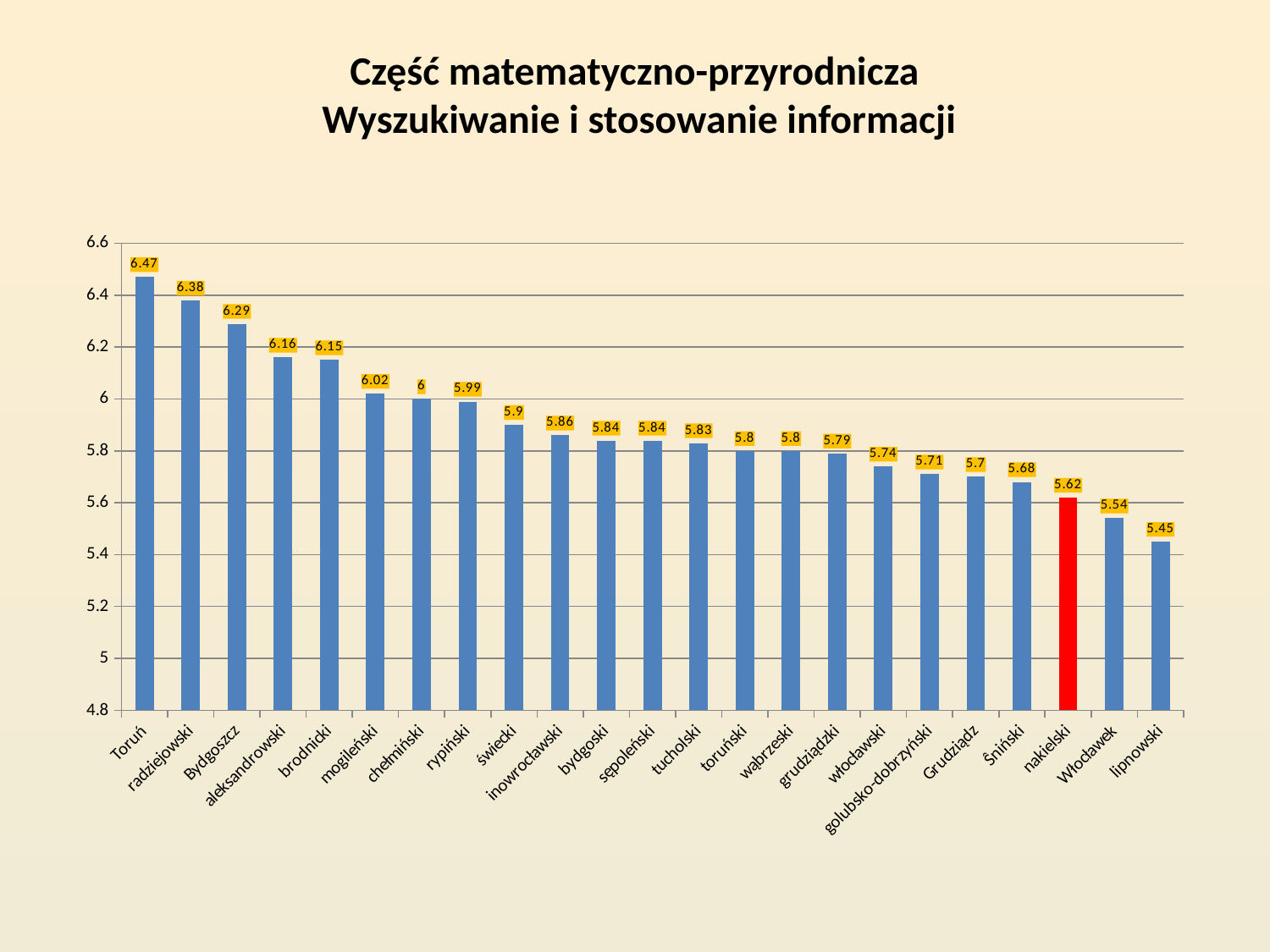
How many categories are shown on the x axis? 23 Which category has the highest value? Toruń What is the value for Toruń? 6.47 Which category has the lowest value? lipnowski What is the value for chełmiński? 6 What kind of chart is shown on the slide? bar chart Which has a larger value, radziejowski or Włocławek? radziejowski What is the value for nakielski? 5.62 What is the difference between the values for Toruń and lipnowski? 1.02 What is the difference between the values for Bydgoszcz and Grudziądz? 0.59 What is the value for golubsko-dobrzyński? 5.71 Which bar is coloured red instead of blue? nakielski